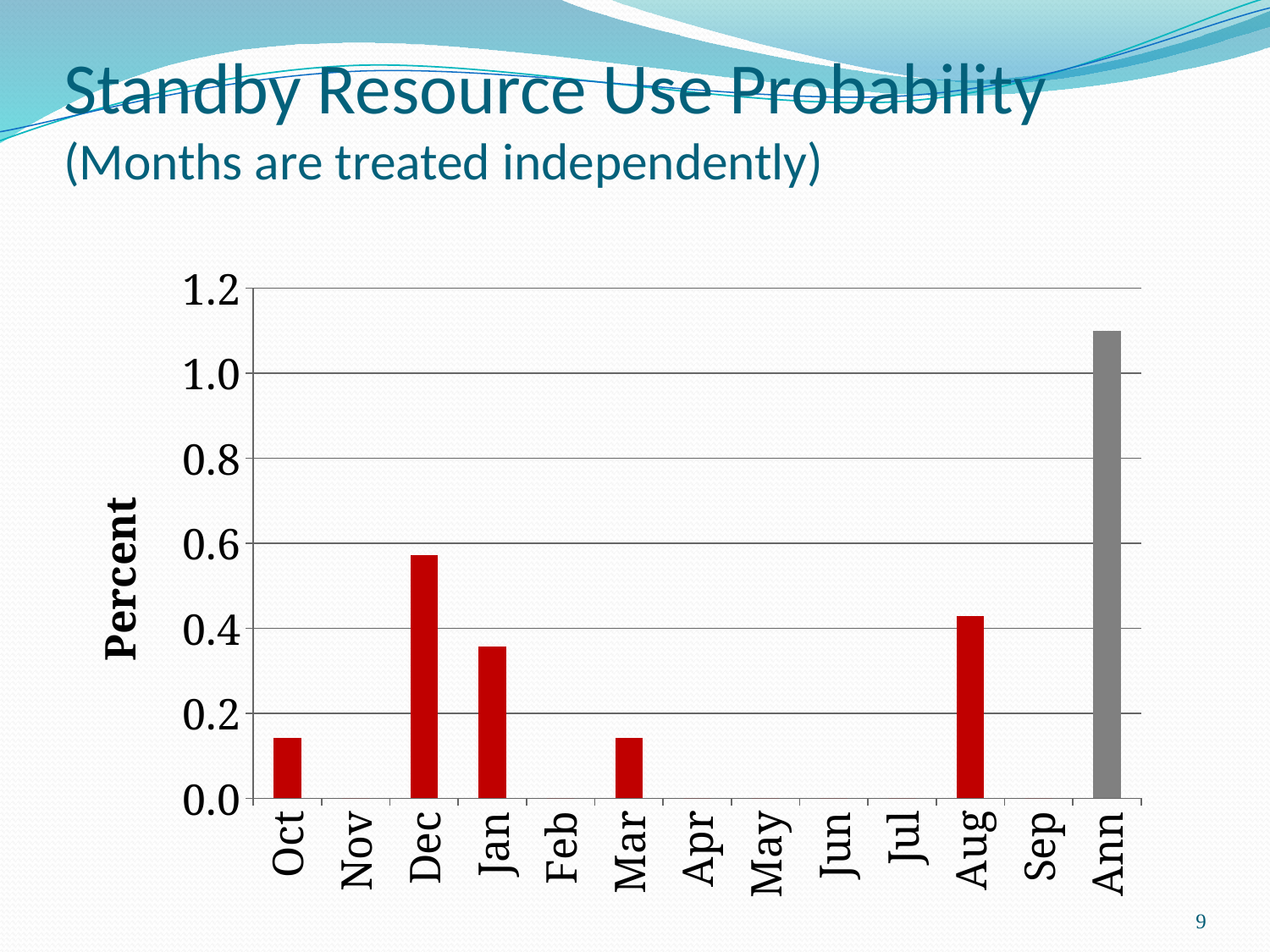
Is the value for Ann greater or less than 1.0? greater How many categories are shown on the x axis of the chart? 13 Is the value for Dec greater or less than 0.4? greater Among the individual months (excluding Ann), which month has the highest bar? Dec What kind of chart is shown on the slide? bar chart Is the value for Oct greater or less than 0.2? less What is the label on the y axis of the chart? Percent Which category has the highest bar in the chart? Ann Which has the larger value, Dec or Jan? Dec Which has the larger value, Aug or Oct? Aug